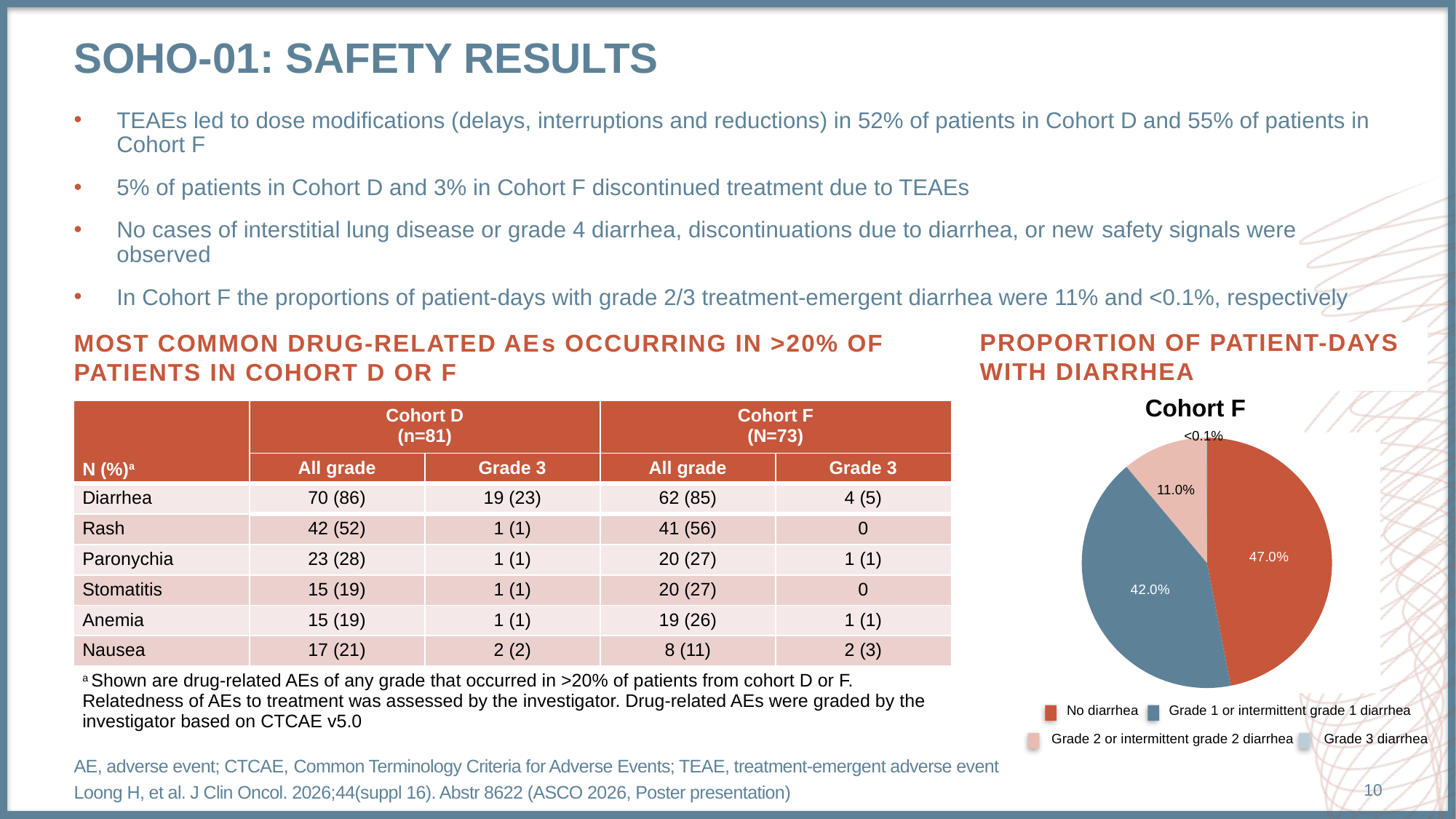
In the Cohort F pie chart, what is the value for grade 2 or intermittent grade 2 diarrhea? 11.0% Which category has the largest slice in the Cohort F pie chart? No diarrhea In the Cohort F pie chart, what value is shown for grade 3 diarrhea? <0.1% What is the title printed above the pie chart? Cohort F Which category has the smallest slice in the Cohort F pie chart? Grade 3 diarrhea How many entries does the legend of the Cohort F pie chart list? 4 In the Cohort F pie chart, what is the share of patient-days with grade 1 or intermittent grade 1 diarrhea? 42.0% What kind of chart is shown under "Proportion of patient-days with diarrhea"? pie chart In the Cohort F pie chart, what percentage of patient-days had no diarrhea? 47.0% In the Cohort F pie chart, what is the difference between the no diarrhea share and the grade 1 or intermittent grade 1 diarrhea share? 5.0% In the Cohort F pie chart, what colour is the "No diarrhea" slice? red-orange In the Cohort F pie chart, which is larger: the grade 1 or intermittent grade 1 diarrhea slice or the grade 2 or intermittent grade 2 diarrhea slice? Grade 1 or intermittent grade 1 diarrhea